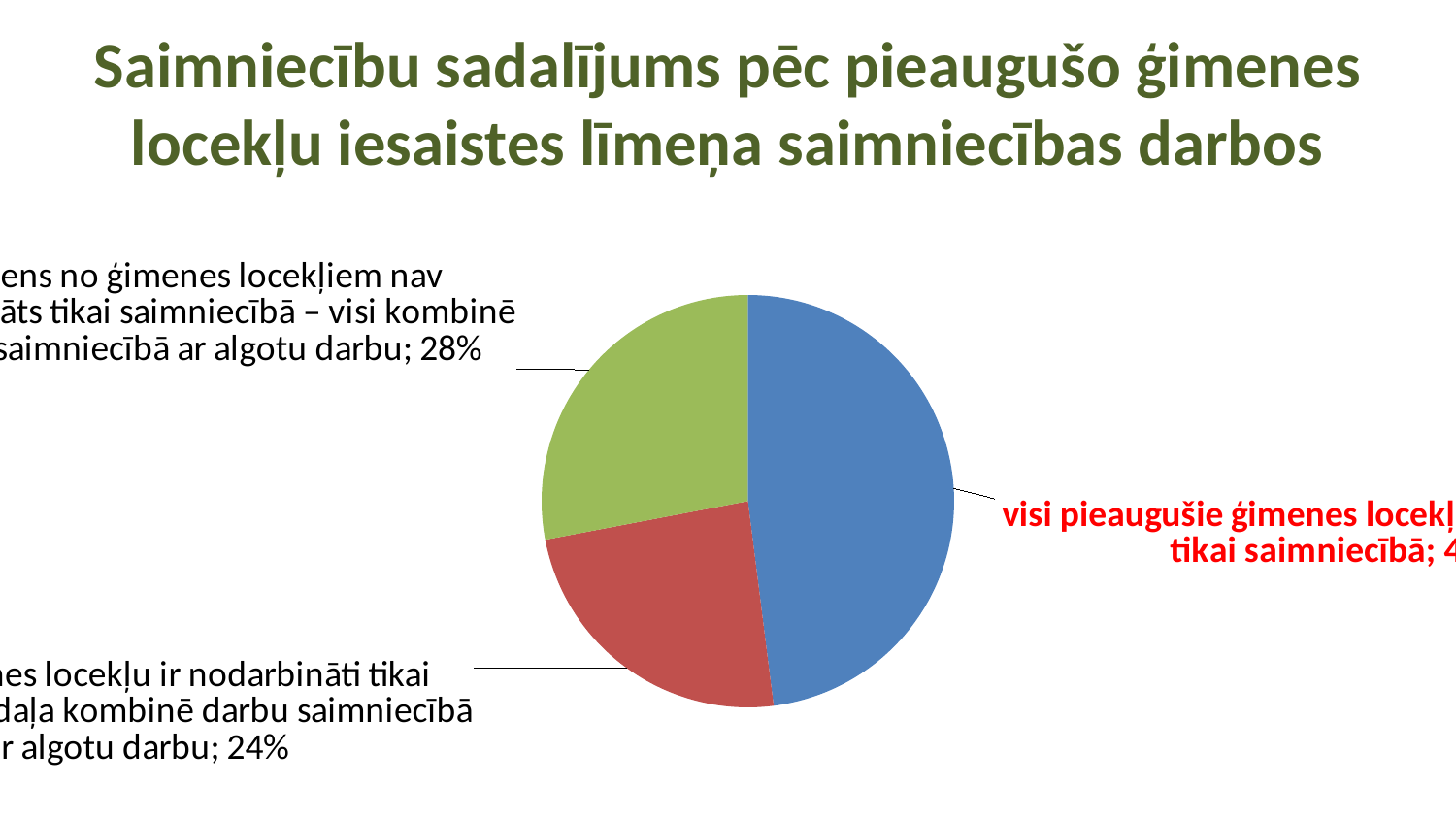
What colour is the largest slice of the pie chart? Blue How many slices does the pie chart have? 3 Which slice of the pie chart is the smallest? The red slice (24%) What percentage is shown for the red slice (the label ending "r algotu darbu")? 24% Which is larger, the green slice or the red slice? The green slice (28%) What percentage is shown for the green slice (the label ending "saimniecībā ar algotu darbu")? 28% Which slice of the pie chart is the largest? The blue slice (visi pieaugušie ģimenes locekļi ... tikai saimniecībā) What type of chart is shown on the slide? Pie chart What is the title of the chart on the slide? Saimniecību sadalījums pēc pieaugušo ģimenes locekļu iesaistes līmeņa saimniecības darbos What is the difference in percentage points between the green slice (28%) and the red slice (24%)? 4 percentage points